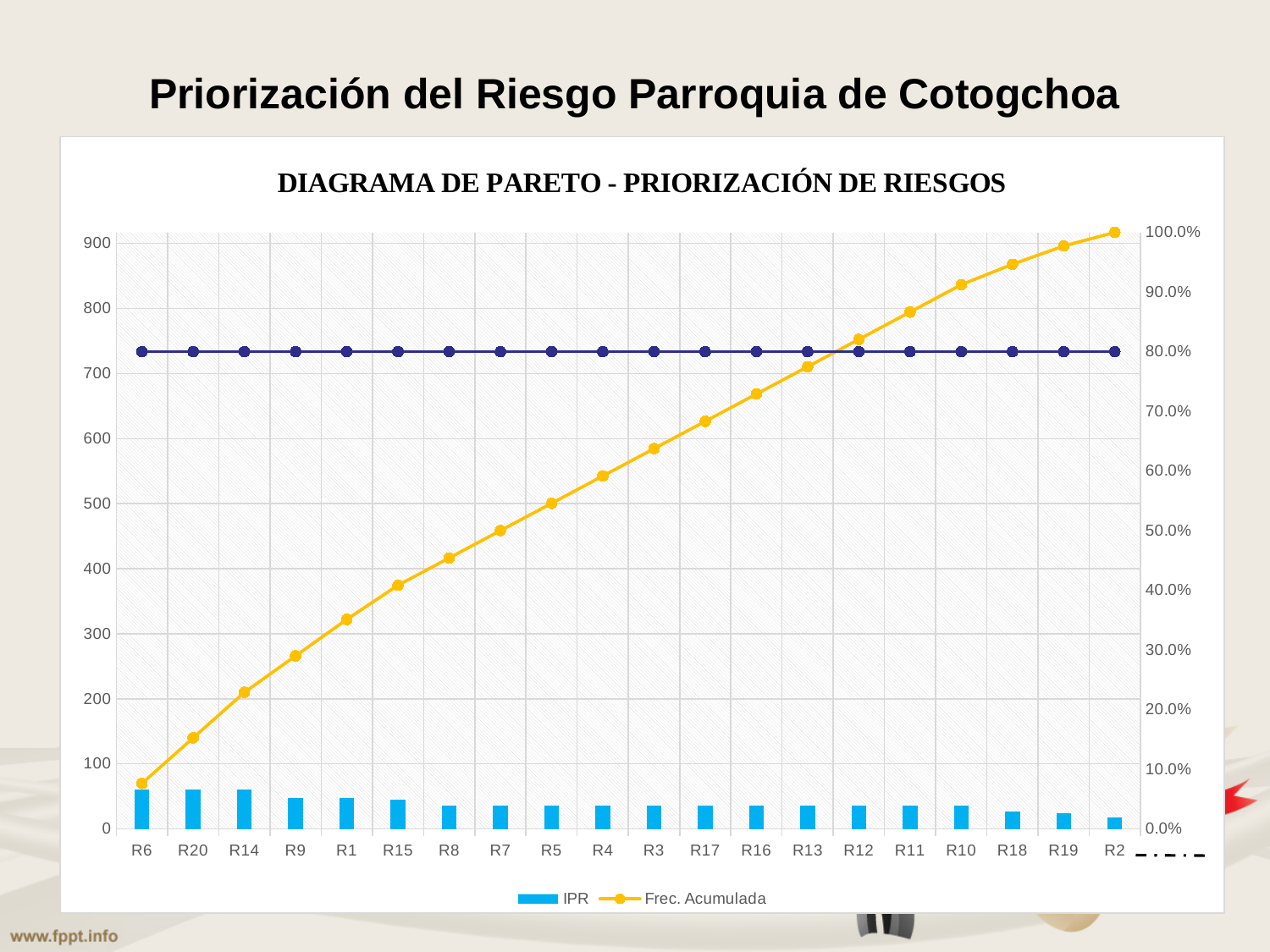
How many risk categories are shown on the x axis? 20 What kind of chart is shown on the slide? A combined bar and line chart (Pareto chart) Which category has the lowest IPR bar? R2 Is the IPR value for R6 greater or less than 100? less Is the Frec. Acumulada value for R16 greater or less than 80.0%? less Which has a larger IPR value, R6 or R2? R6 Does the Frec. Acumulada line rise or fall from left to right along the x axis? rise What is the title of the chart? DIAGRAMA DE PARETO - PRIORIZACIÓN DE RIESGOS Is the Frec. Acumulada value for R5 greater or less than 50.0%? greater Which category appears first on the x axis? R6 What is the highest value shown on the left vertical axis? 900